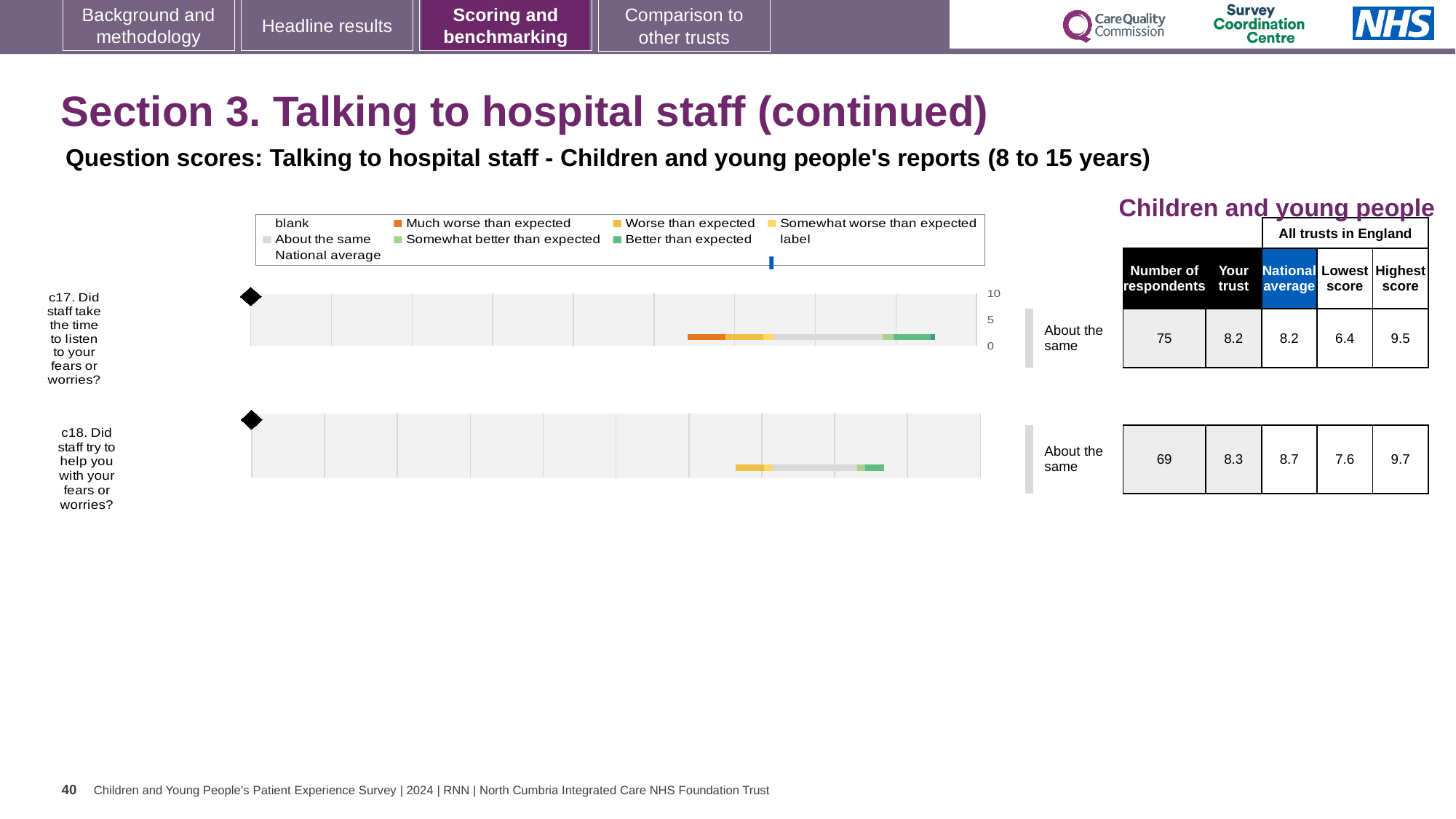
Which legend entry is shown in orange? Much worse than expected What is the lowest score among all trusts in England for question c17? 6.4 Which question has more respondents, c17 or c18? c17 How many respondents answered question c17? 75 What benchmark category is the trust's result for question c17 placed in? About the same What is the trust's score for question c17 (Did staff take the time to listen to your fears or worries?)? 8.2 How many questions are plotted on the slide? 2 What is the national average for question c18 (Did staff try to help you with your fears or worries?)? 8.7 What is the highest score among all trusts in England for question c18? 9.7 What is the difference between the national average and the trust's score for question c18? 0.4 What kind of chart is used to show the question scores? Bar chart Which question has the higher trust score, c17 or c18? c18